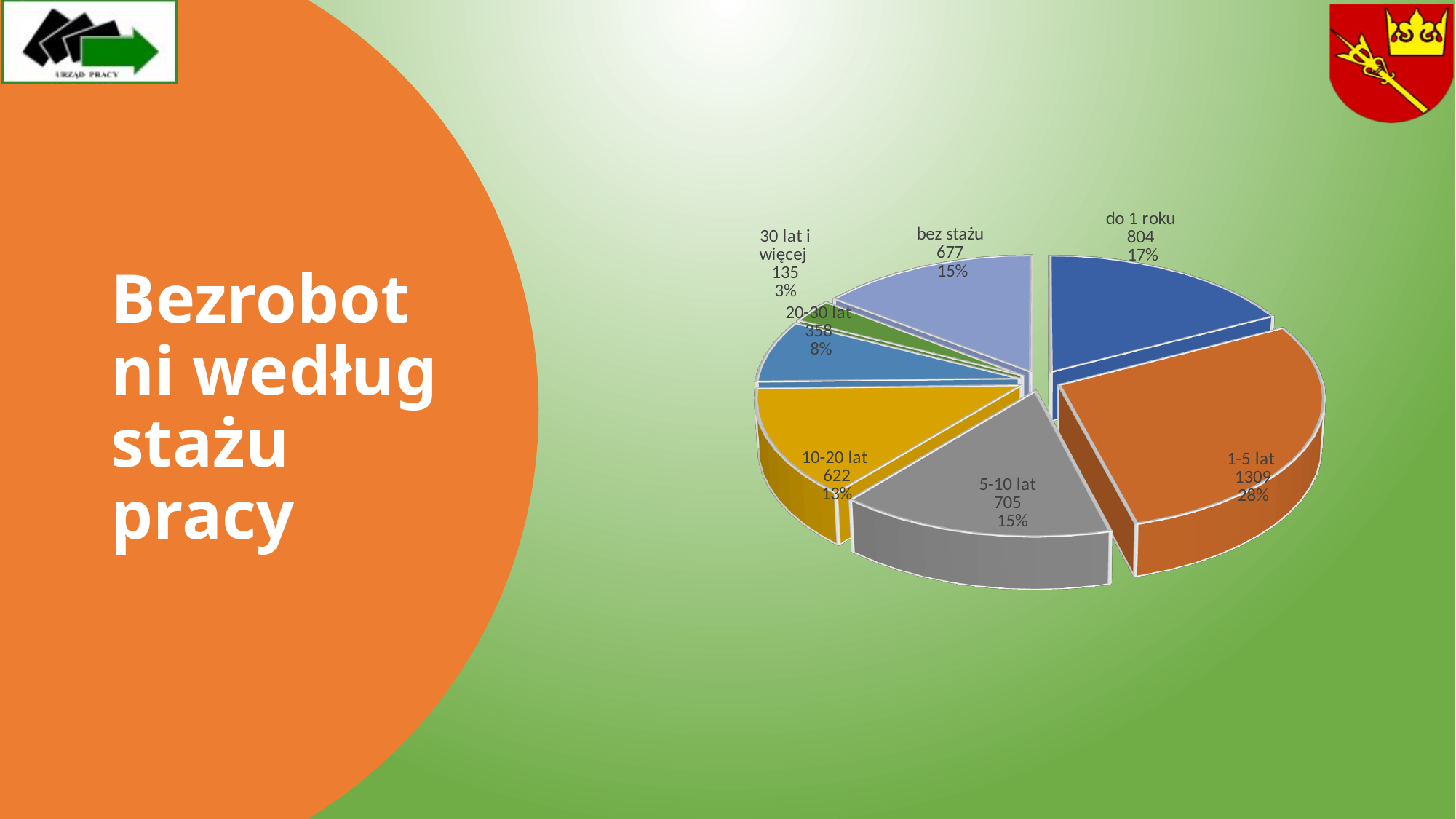
What is the value for the 'bez stażu' slice? 677 Which category has the largest slice? 1-5 lat What share of the pie does the '10-20 lat' slice represent? 13% What is the difference between the values for '1-5 lat' and 'do 1 roku'? 505 What share of the pie does the '5-10 lat' slice represent? 15% What is the value for the 'do 1 roku' slice? 804 How many slices does the pie chart have? 7 What is the value for the '1-5 lat' slice? 1309 Which is larger, the value for '5-10 lat' or the value for '10-20 lat'? 5-10 lat Which category has the smallest slice? 30 lat i więcej What kind of chart is shown on the slide? pie chart What is the value for the '20-30 lat' slice? 358